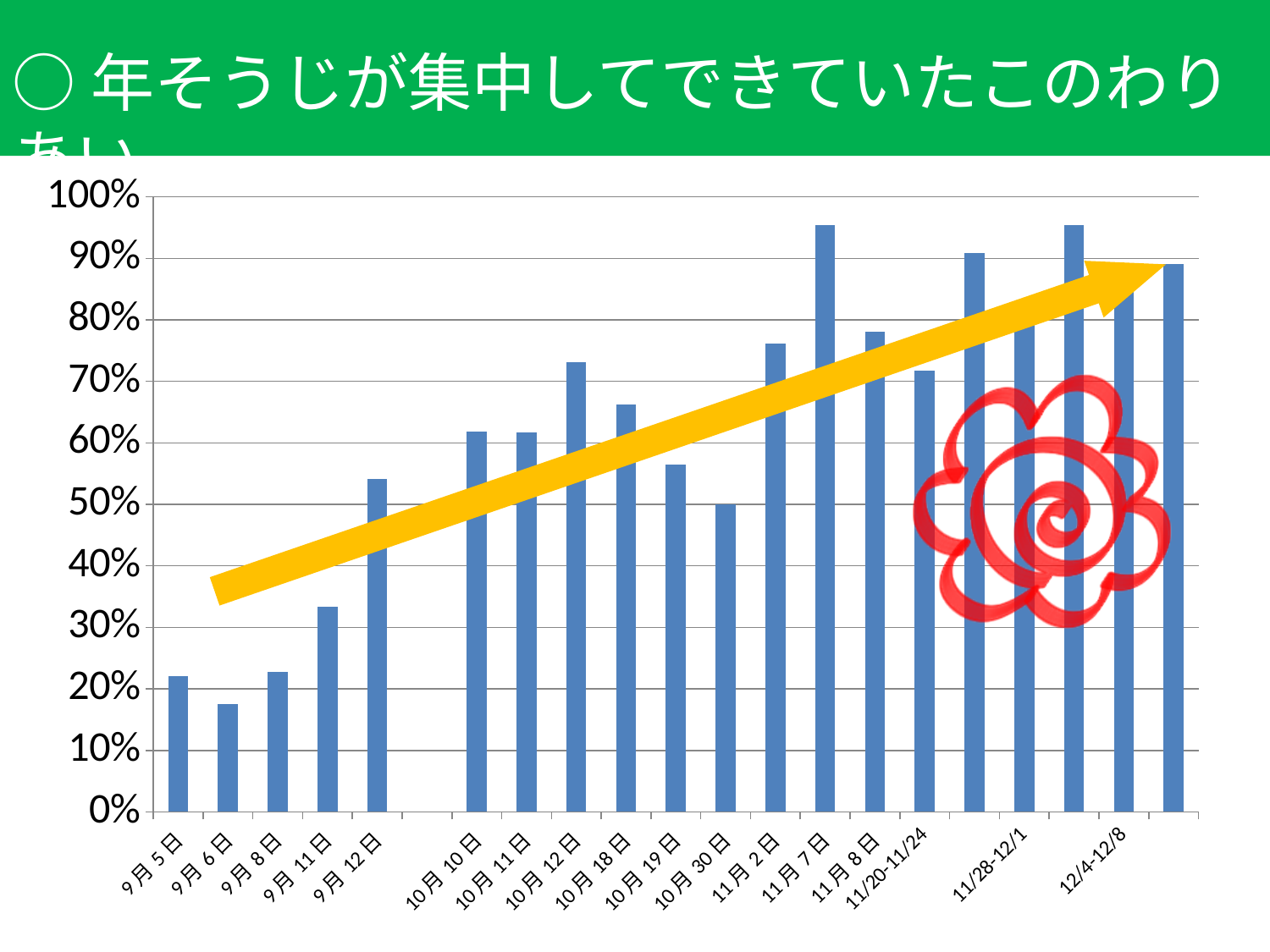
Is the value for 9月6日 greater or less than 20%? less Overall, do the values rise or fall from left to right along the x axis? rise What is the highest value shown on the vertical axis? 100% What kind of chart is shown on the slide? bar chart Which has the larger value, 10月12日 or 10月18日? 10月12日 Is the value for 11月2日 greater or less than 70%? greater Is the value for 10月12日 greater or less than 70%? greater Which has the larger value, 9月11日 or 9月12日? 9月12日 Which labeled date has the lowest value? 9月6日